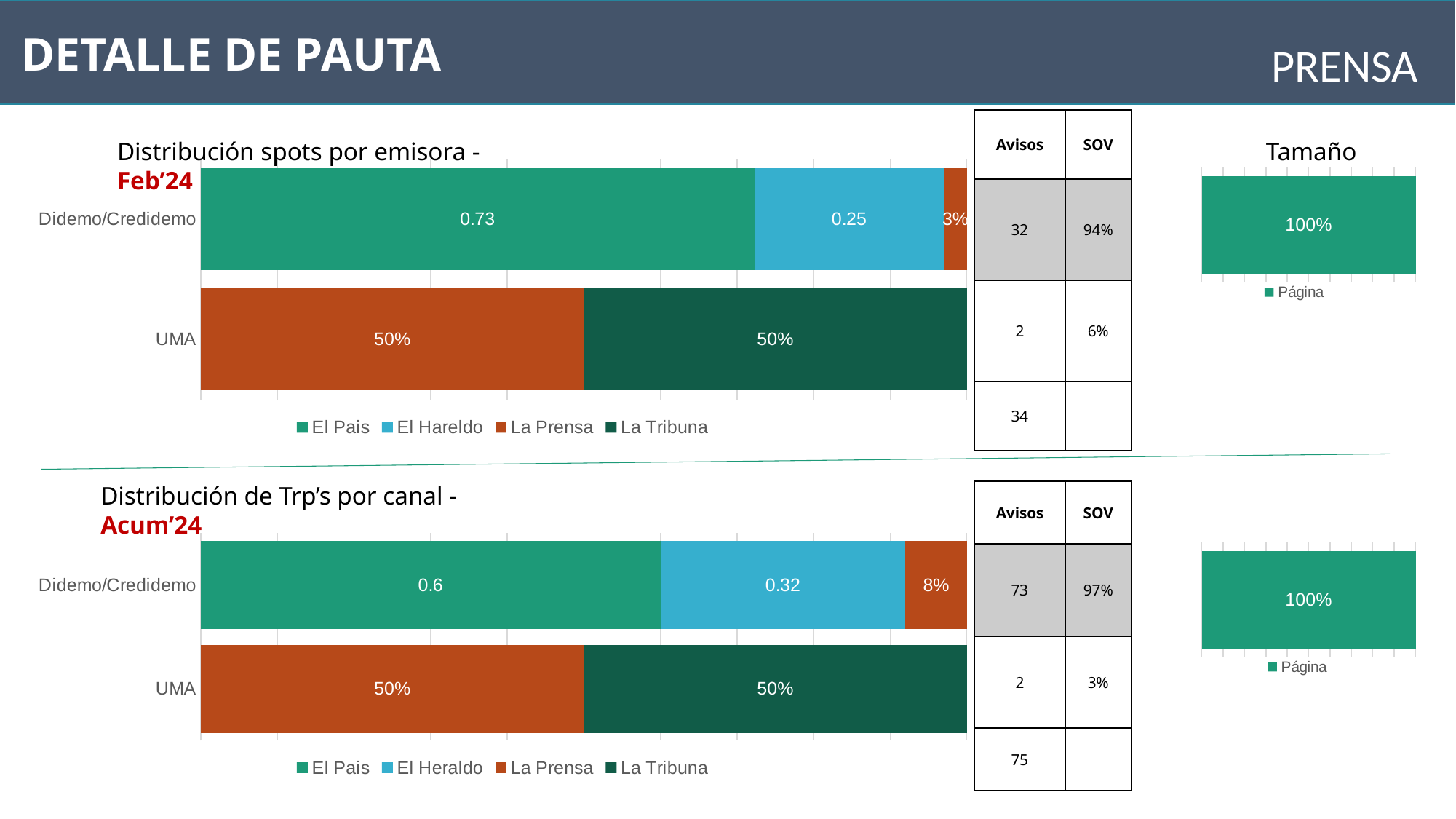
In the bottom chart 'Distribución de Trp's por canal - Acum'24', what is the value for El Pais in the Didemo/Credidemo bar? 0.6 In the bottom chart 'Distribución de Trp's por canal - Acum'24', what is the value for La Prensa in the Didemo/Credidemo bar? 8% In the top chart 'Distribución spots por emisora - Feb'24', what is the value for El Pais in the Didemo/Credidemo bar? 0.73 In the bottom chart 'Distribución de Trp's por canal - Acum'24', what is the value for El Heraldo in the Didemo/Credidemo bar? 0.32 How many categories are shown on the y axis of the bottom chart 'Distribución de Trp's por canal - Acum'24'? 2 In the top chart 'Distribución spots por emisora - Feb'24', what is the value for La Prensa in the UMA bar? 50% In the upper 'Tamaño' chart on the right, what value is shown for Página? 100% In the top chart 'Distribución spots por emisora - Feb'24', which series has the largest segment in the Didemo/Credidemo bar? El Pais What kind of chart is the top chart 'Distribución spots por emisora - Feb'24'? Stacked bar chart How many series does the legend of the top chart 'Distribución spots por emisora - Feb'24' list? 4 In the top chart 'Distribución spots por emisora - Feb'24', what is the value for El Hareldo in the Didemo/Credidemo bar? 0.25 In the bottom chart 'Distribución de Trp's por canal - Acum'24', what is the difference between the El Pais and El Heraldo values in the Didemo/Credidemo bar? 0.28